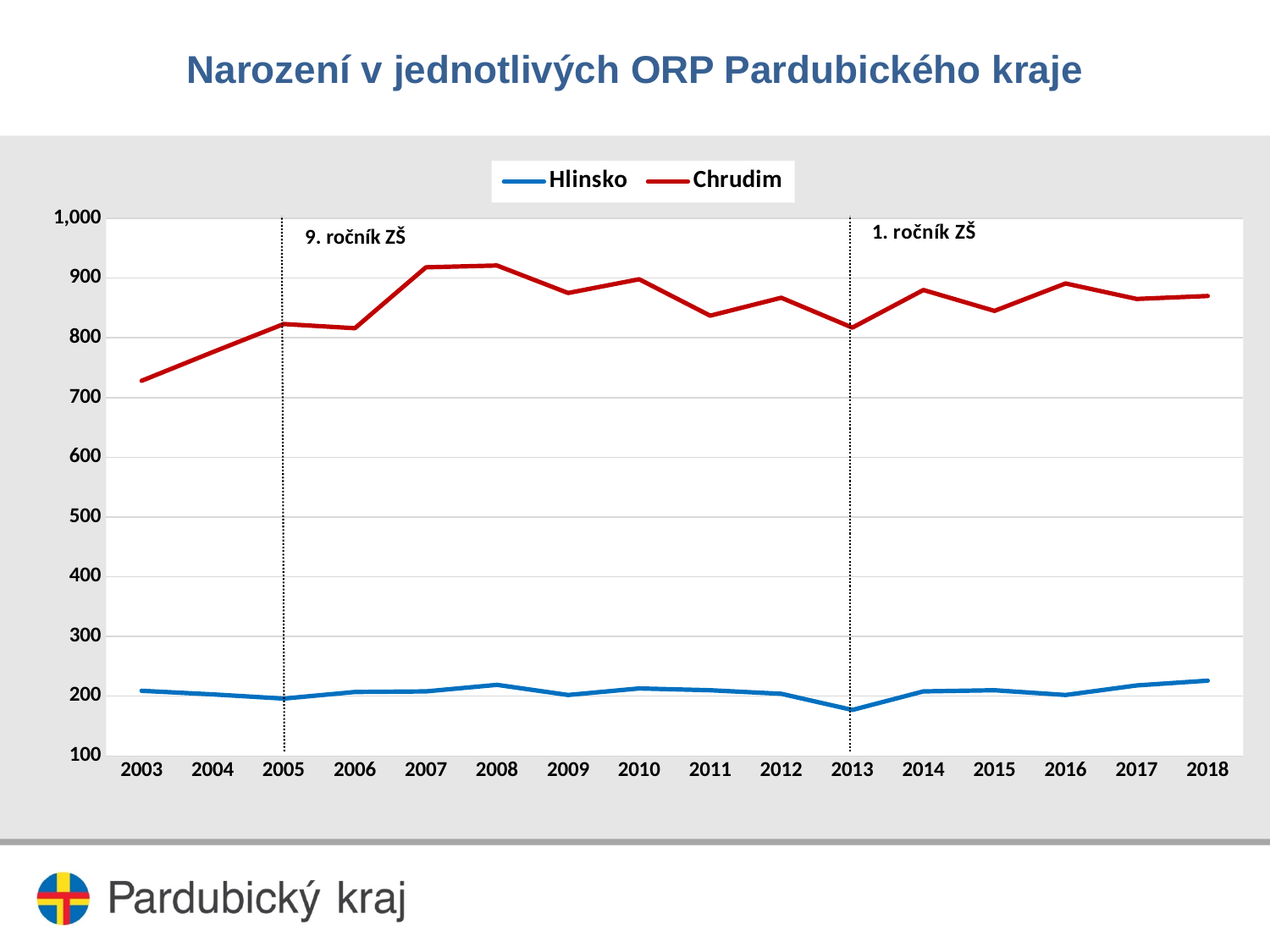
Is the value for Chrudim in 2003 greater or less than 800? less What kind of chart is shown on the slide? line chart In which year is the value for Chrudim lowest? 2003 Which is larger for Chrudim: the value in 2003 or the value in 2018? 2018 Which series is drawn in red? Chrudim How many series does the legend list? 2 Does the value for Chrudim rise or fall from 2003 to 2005? rise What label is written next to the dotted vertical line at 2013? 1. ročník ZŠ Is the value for Chrudim in 2007 greater or less than 900? greater How many years are shown on the x axis? 16 In which year is the value for Hlinsko lowest? 2013 Is the value for Hlinsko in 2013 greater or less than 200? less